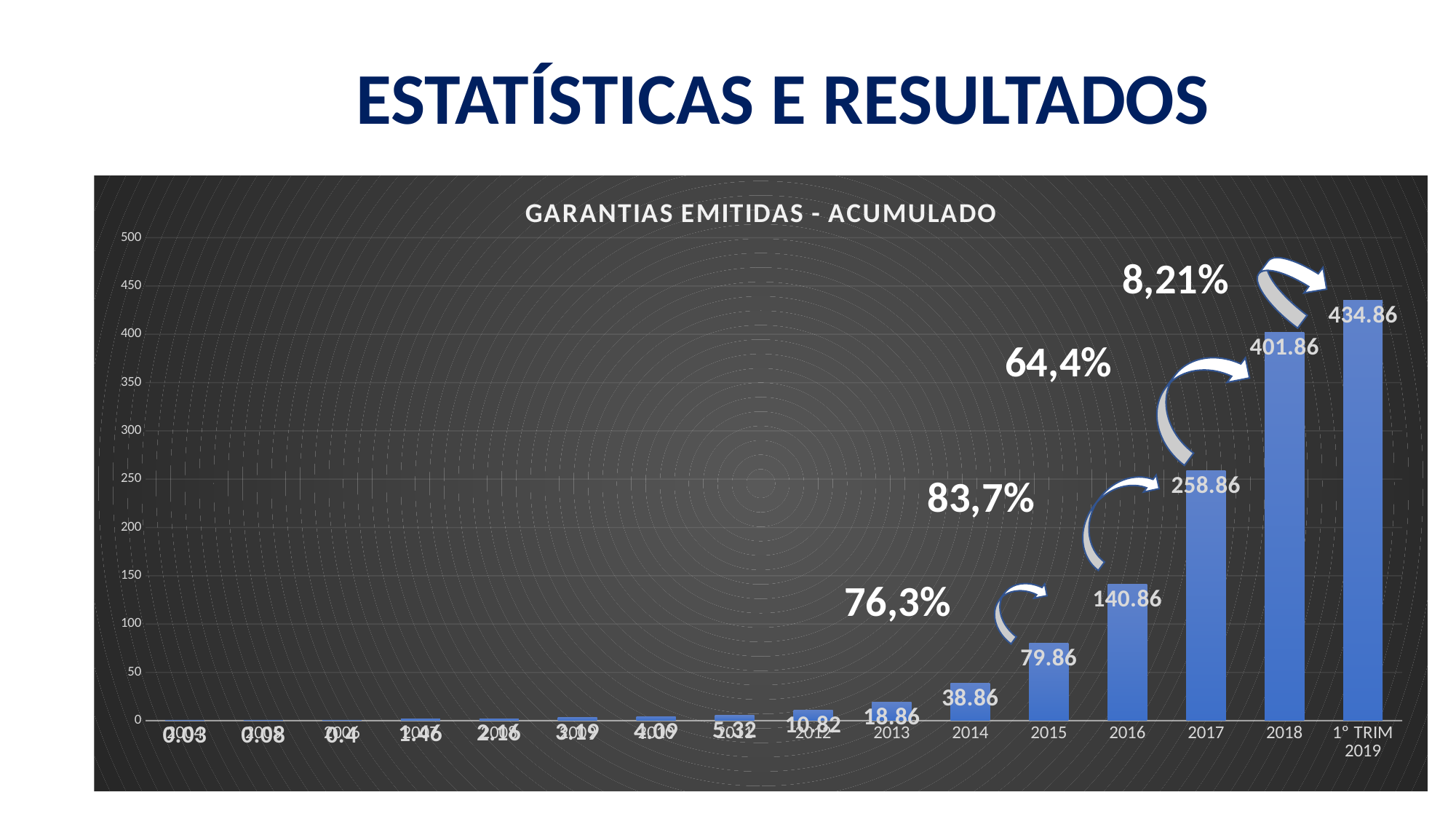
What is the value for 2014 in the chart? 38.86 Is the value for 2017 greater or less than 250? greater Which category has the highest value in the chart? 1º TRIM 2019 What is the value for 1º TRIM 2019 in the chart? 434.86 Do the values rise or fall from 2012 to 1º TRIM 2019? Rise Which is larger, the value for 2015 or the value for 2013? 2015 What kind of chart is shown on the slide? Bar chart What is the difference between the values for 1º TRIM 2019 and 2018? 33 What is the title of the chart? GARANTIAS EMITIDAS - ACUMULADO What is the value for 2018 in the chart? 401.86 What is the difference between the values for 2017 and 2016? 118 What is the value for 2016 in the GARANTIAS EMITIDAS - ACUMULADO chart? 140.86